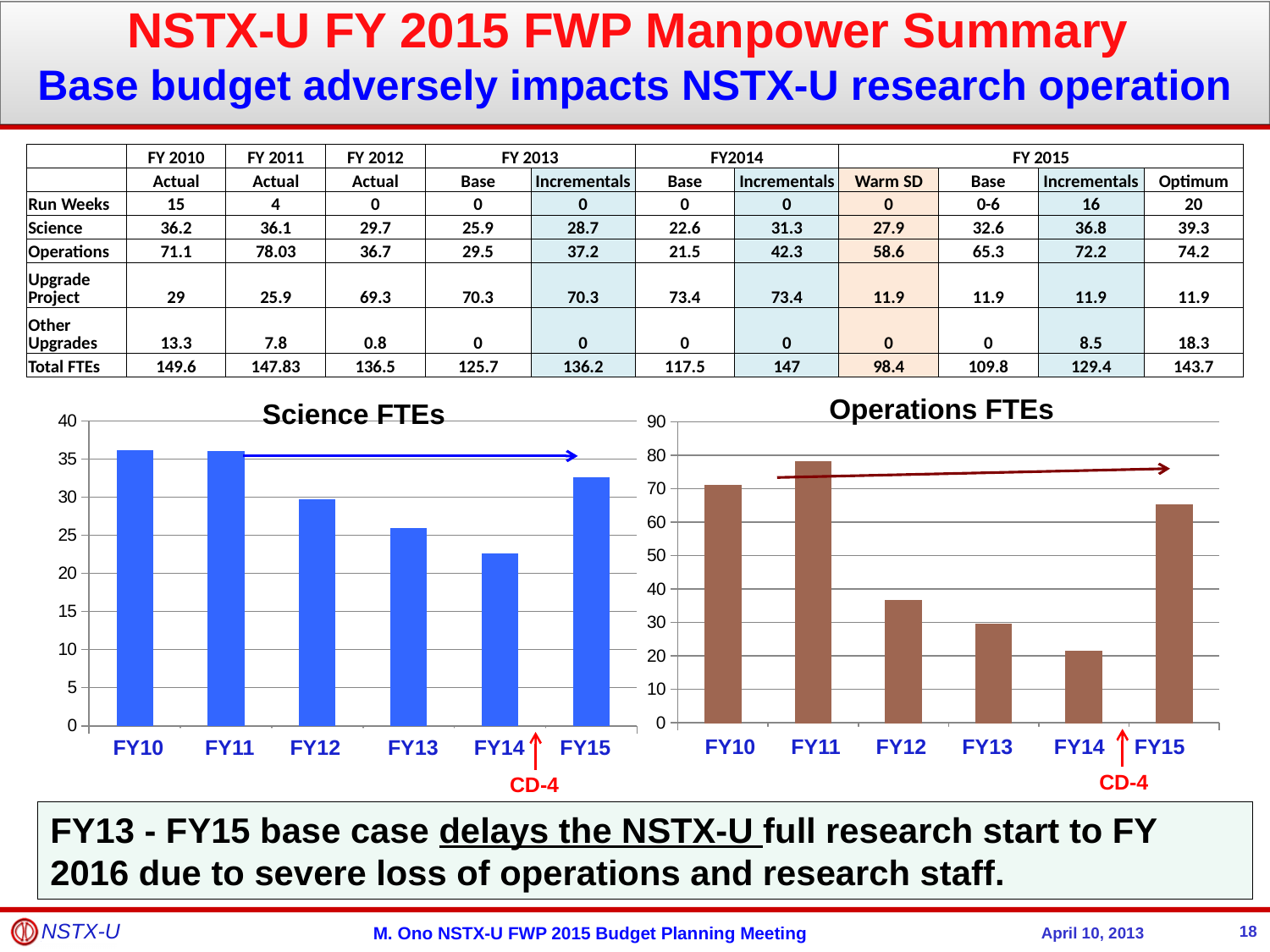
In the Science FTEs chart, which fiscal year has the lowest value? FY14 In the Operations FTEs chart, is the value for FY15 greater or less than 60? greater In the Operations FTEs chart, is the value for FY12 greater or less than 40? less In the Science FTEs chart, which fiscal year has the highest value? FY10 In the Science FTEs chart, is the value for FY15 greater or less than 30? greater How many fiscal years are shown on the x axis of the Operations FTEs chart? 6 In the Operations FTEs chart, which fiscal year has the highest value? FY11 What kind of chart is the Science FTEs chart? bar chart In the Operations FTEs chart, which fiscal year has the lowest value? FY14 In the Science FTEs chart, do the values rise or fall from FY10 to FY14? fall In the Science FTEs chart, which is larger, the value for FY12 or the value for FY13? FY12